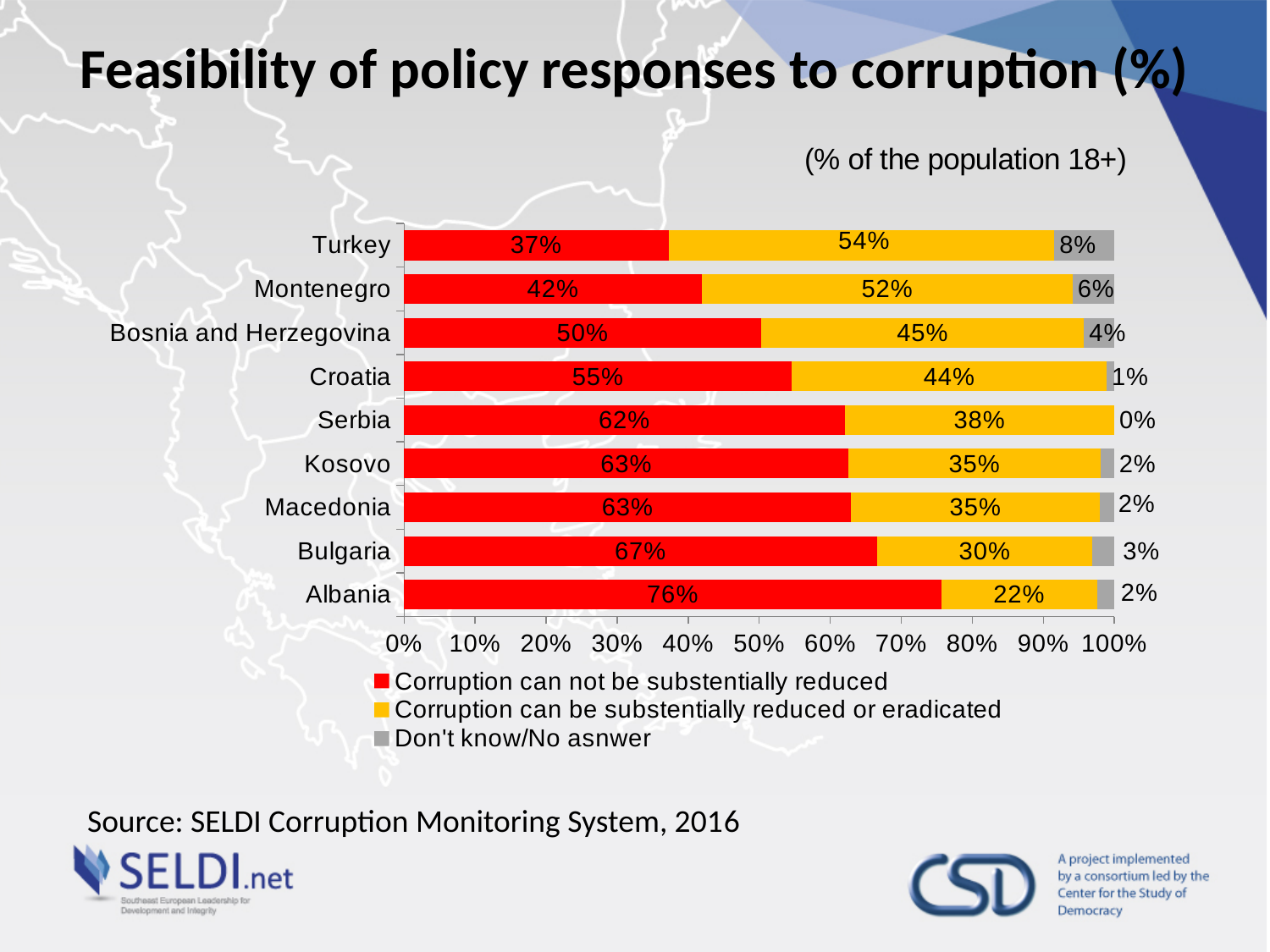
Which is larger: the share saying corruption can be substantially reduced or eradicated in Montenegro or in Croatia? Montenegro Which colour represents 'Don't know/No answer' in the chart? Grey Which country has the lowest share saying corruption can not be substantially reduced? Turkey Which country has the highest share saying corruption can not be substantially reduced? Albania What percentage of respondents in Albania say corruption can not be substantially reduced? 76% What is the 'Don't know/No answer' share for Bulgaria? 3% What percentage of respondents in Turkey say corruption can be substantially reduced or eradicated? 54% How many series does the legend list? 3 What is the total of the three segments for Bulgaria? 100% What is the difference between Albania's and Turkey's shares saying corruption can not be substantially reduced? 39 percentage points How many countries are shown in the chart? 9 What type of chart is shown on the slide? Stacked bar chart